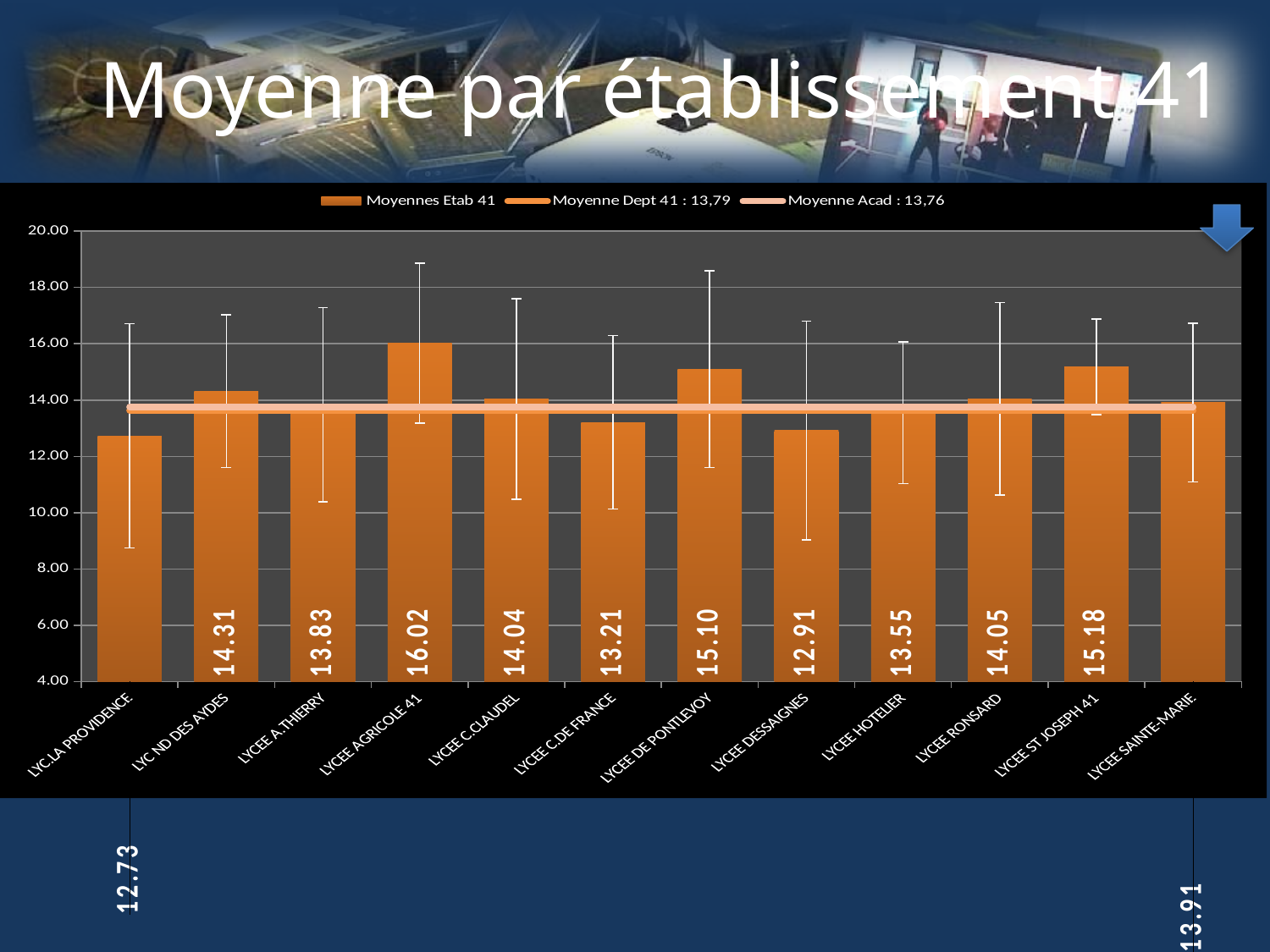
What is the value for LYCEE AGRICOLE 41? 16.02 How many establishments are shown on the x axis? 12 According to the legend, what is the value of Moyenne Dept 41? 13,79 Which is larger, the value for LYCEE ST JOSEPH 41 or the value for LYCEE DE PONTLEVOY? LYCEE ST JOSEPH 41 What is the value for LYCEE HOTELIER? 13.55 How many series does the legend list? 3 What kind of chart is shown on the slide? combination bar and line chart Is the value for LYCEE C.DE FRANCE greater or less than 14.00? less What is the difference between the values for LYCEE AGRICOLE 41 and LYCEE DESSAIGNES? 3.11 Which establishment has the highest average? LYCEE AGRICOLE 41 Which establishment has the lowest average? LYC.LA PROVIDENCE What is the value for LYCEE DE PONTLEVOY? 15.10